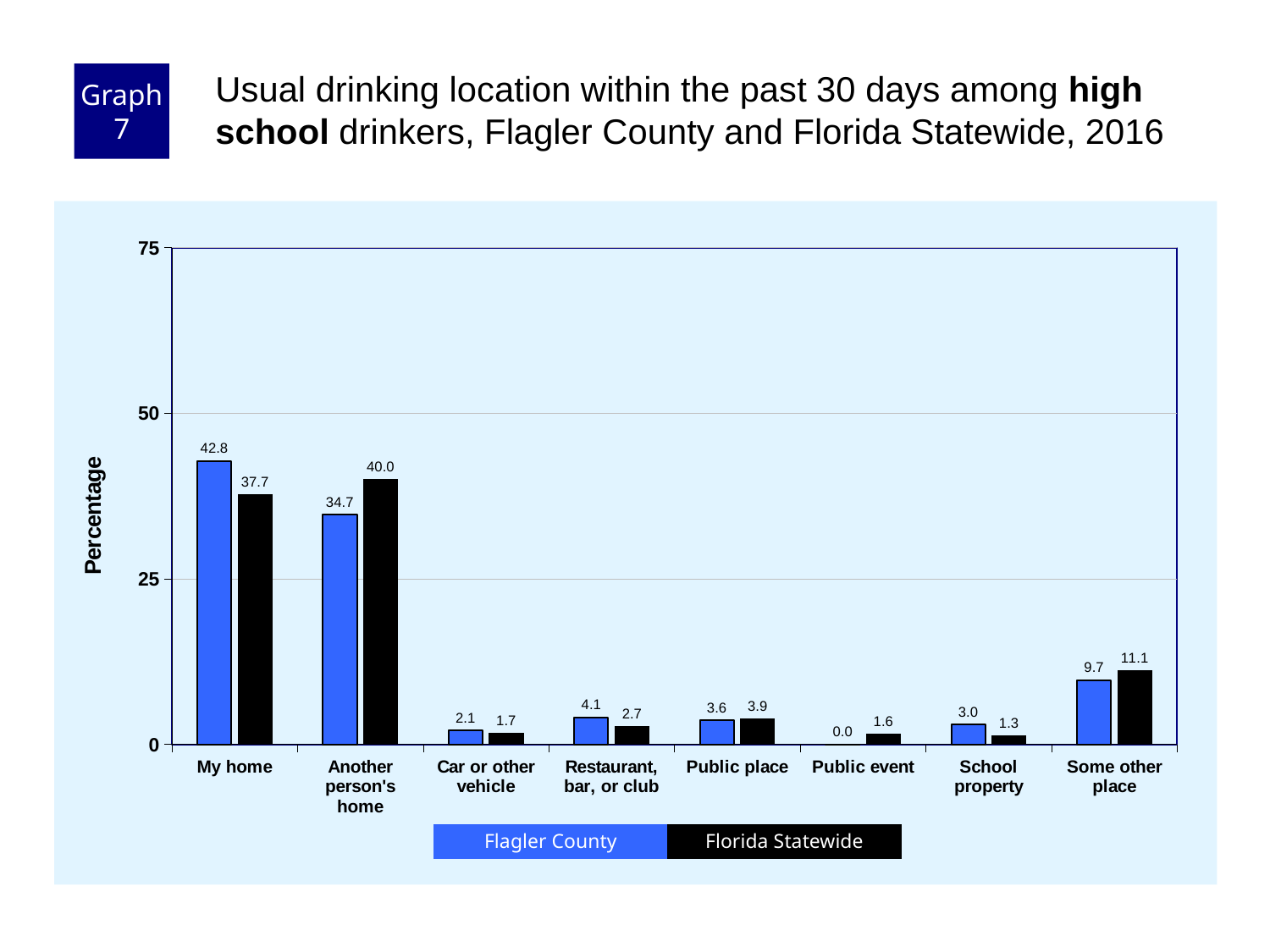
What kind of chart is shown? bar chart What is the label of the y axis? Percentage Which is larger for Some other place, Flagler County or Florida Statewide? Florida Statewide Is the Florida Statewide value for Another person's home greater or less than 25? greater How many series does the legend list? 2 Which category has the highest Flagler County value? My home How many location categories are shown on the x axis? 8 What is the Florida Statewide value for Another person's home? 40.0 What is the difference between the Flagler County and Florida Statewide values for My home? 5.1 What is the Flagler County value for My home? 42.8 What is the Flagler County value for Public event? 0.0 Which category has the lowest Florida Statewide value? School property